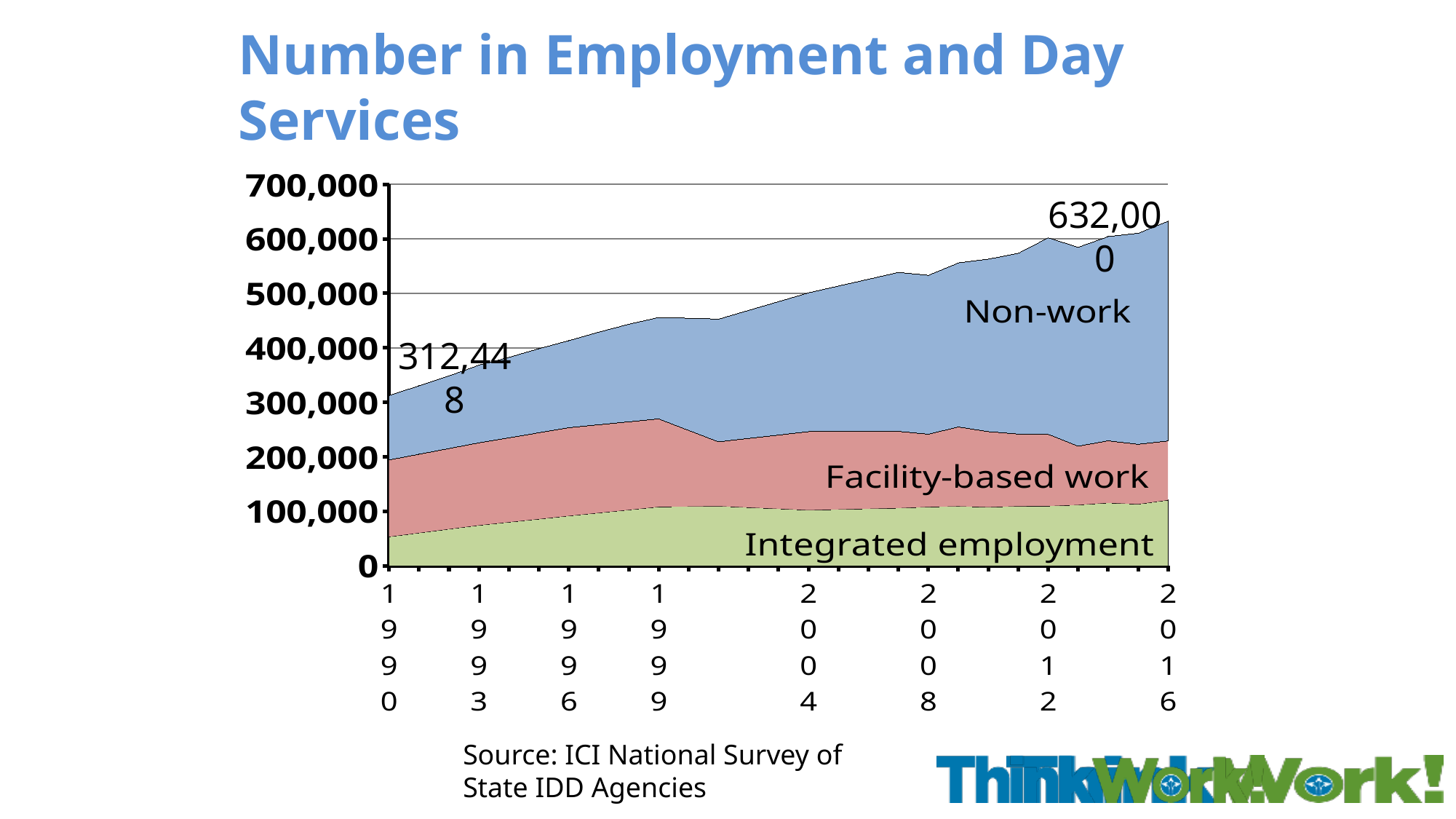
What kind of chart is shown on the slide? stacked area chart Which is larger, the total for 1990 or the total for 2016? 2016 How many series (areas) are shown in the chart? 3 Is the total number in employment and day services in 2004 greater or less than 400,000? greater What is the title of the chart? Number in Employment and Day Services Is the value for Integrated employment in 1990 greater or less than 100,000? less Does the total number in employment and day services rise or fall from 1990 to 2016? rise How many year labels are shown on the x axis? 8 What is the total number in employment and day services labelled for 2016? 632,000 Which series is shown at the bottom of the stacked areas? Integrated employment What is the difference between the 2016 total (632,000) and the 1990 total (312,448)? 319,552 What is the total number in employment and day services labelled for 1990? 312,448